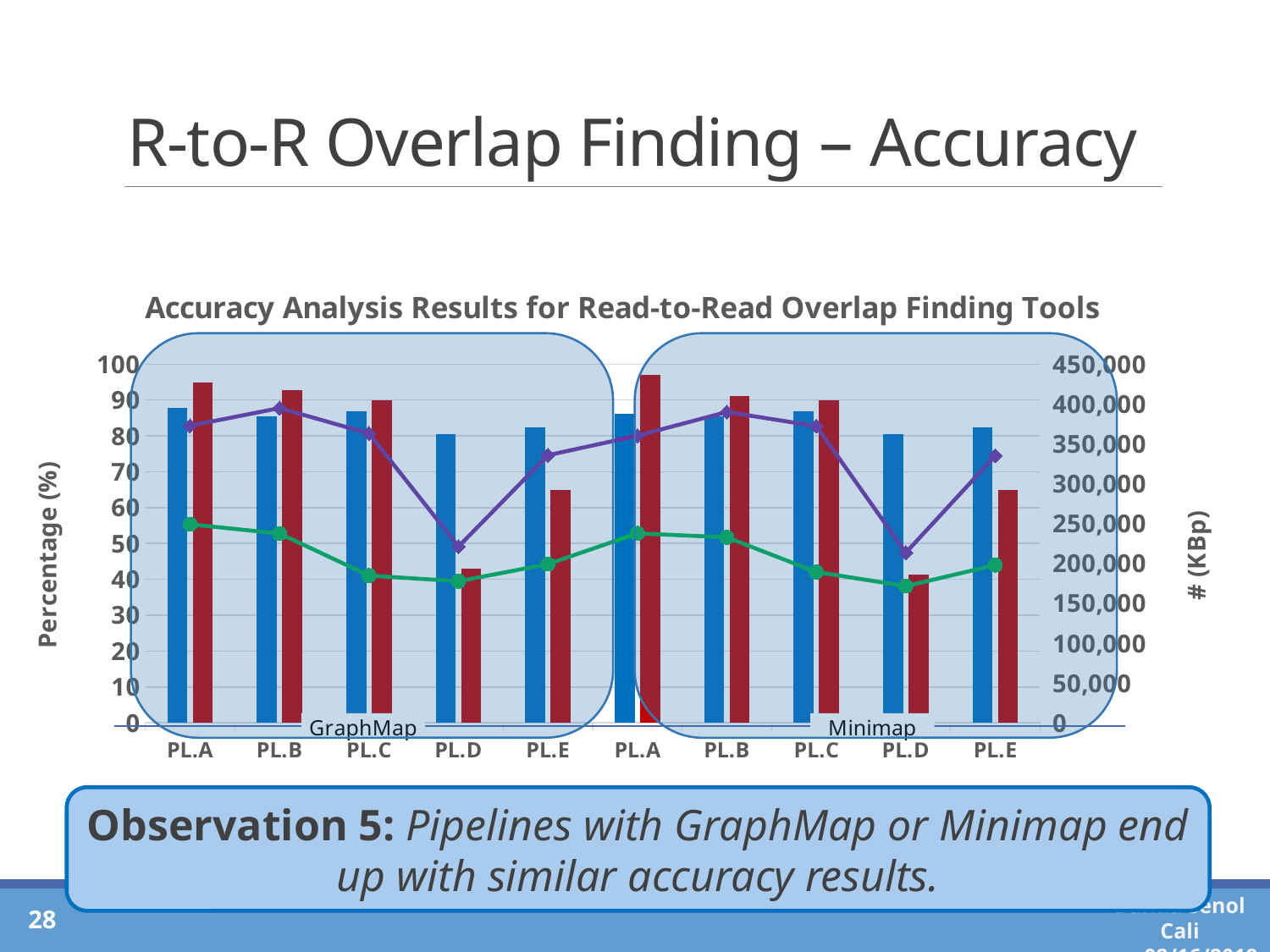
On the left axis scale, is the blue bar for PL.A in the GraphMap group greater or less than 80? greater How many pipeline categories (PL.A to PL.E across both tool groups) are shown on the x axis? 10 Within the GraphMap group, is the red bar for PL.A taller or shorter than the red bar for PL.D? taller Within the GraphMap group, does the purple line rise or fall from PL.C to PL.D? fall Within the Minimap group, is the red bar for PL.E taller or shorter than the blue bar for PL.E? shorter Within the GraphMap group, which category has the lowest red bar? PL.D Does the chart plot its data using bars, lines, or both? both What is the label of the left vertical axis? Percentage (%) Within the Minimap group, which category has the highest red bar? PL.A Within the Minimap group, does the green line rise or fall from PL.D to PL.E? rise On the left axis scale, is the red bar for PL.D in the GraphMap group greater or less than 50? less What is the title of the chart? Accuracy Analysis Results for Read-to-Read Overlap Finding Tools